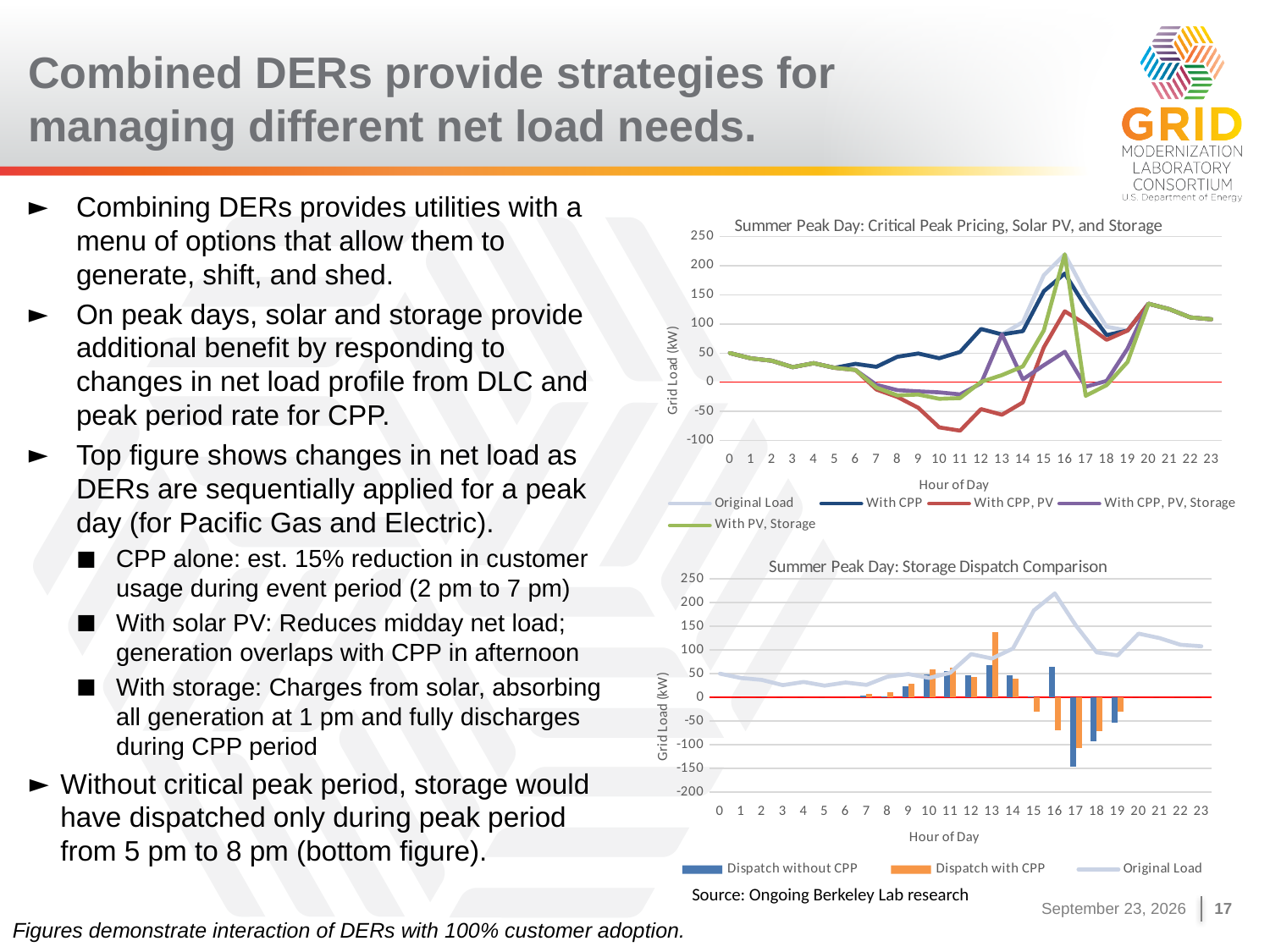
In the top chart, is the 'With CPP, PV' value at hour 11 greater or less than -50? less In the top chart, does the Original Load rise or fall from hour 16 to hour 19? Fall What is the y-axis title of the top chart? Grid Load (kW) In the top chart, how many hours are plotted along the x axis? 24 In the bottom chart, is the 'Dispatch without CPP' value at hour 17 greater or less than -100? less In the top chart, at which hour of day does the Original Load reach its highest value? 16 In the bottom chart, 'Summer Peak Day: Storage Dispatch Comparison', how many series does the legend list? 3 In the bottom chart, at hour 13, which is larger: 'Dispatch with CPP' or 'Dispatch without CPP'? Dispatch with CPP In the top chart, 'Summer Peak Day: Critical Peak Pricing, Solar PV, and Storage', how many series does the legend list? 5 In the bottom chart, is the 'Dispatch with CPP' value at hour 13 greater or less than 100? greater What kind of chart is the top chart, 'Summer Peak Day: Critical Peak Pricing, Solar PV, and Storage'? Line chart